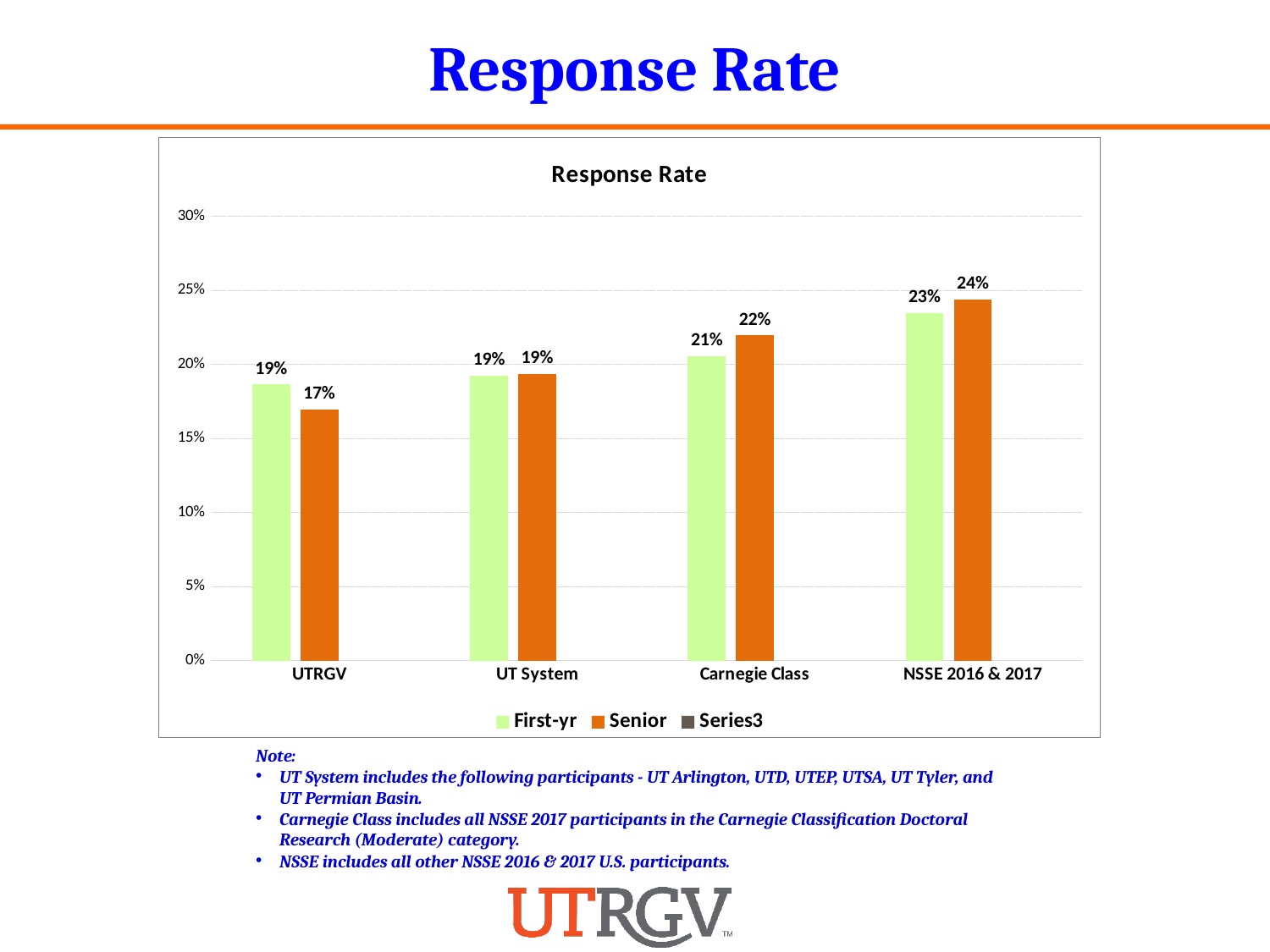
How many series does the legend list? 3 What is the Senior response rate for Carnegie Class? 22% What is the difference between the First-yr and Senior response rates for UTRGV? 2 percentage points Which category has the highest Senior response rate? NSSE 2016 & 2017 What is the Senior response rate for UTRGV? 17% Is the Senior response rate for NSSE 2016 & 2017 greater or less than 20%? greater Which is larger for Carnegie Class, the First-yr or the Senior response rate? Senior What kind of chart is shown on the slide? Bar chart What is the First-yr response rate for UTRGV? 19% How many categories are shown on the x axis? 4 Which category has the lowest Senior response rate? UTRGV What is the First-yr response rate for NSSE 2016 & 2017? 23%